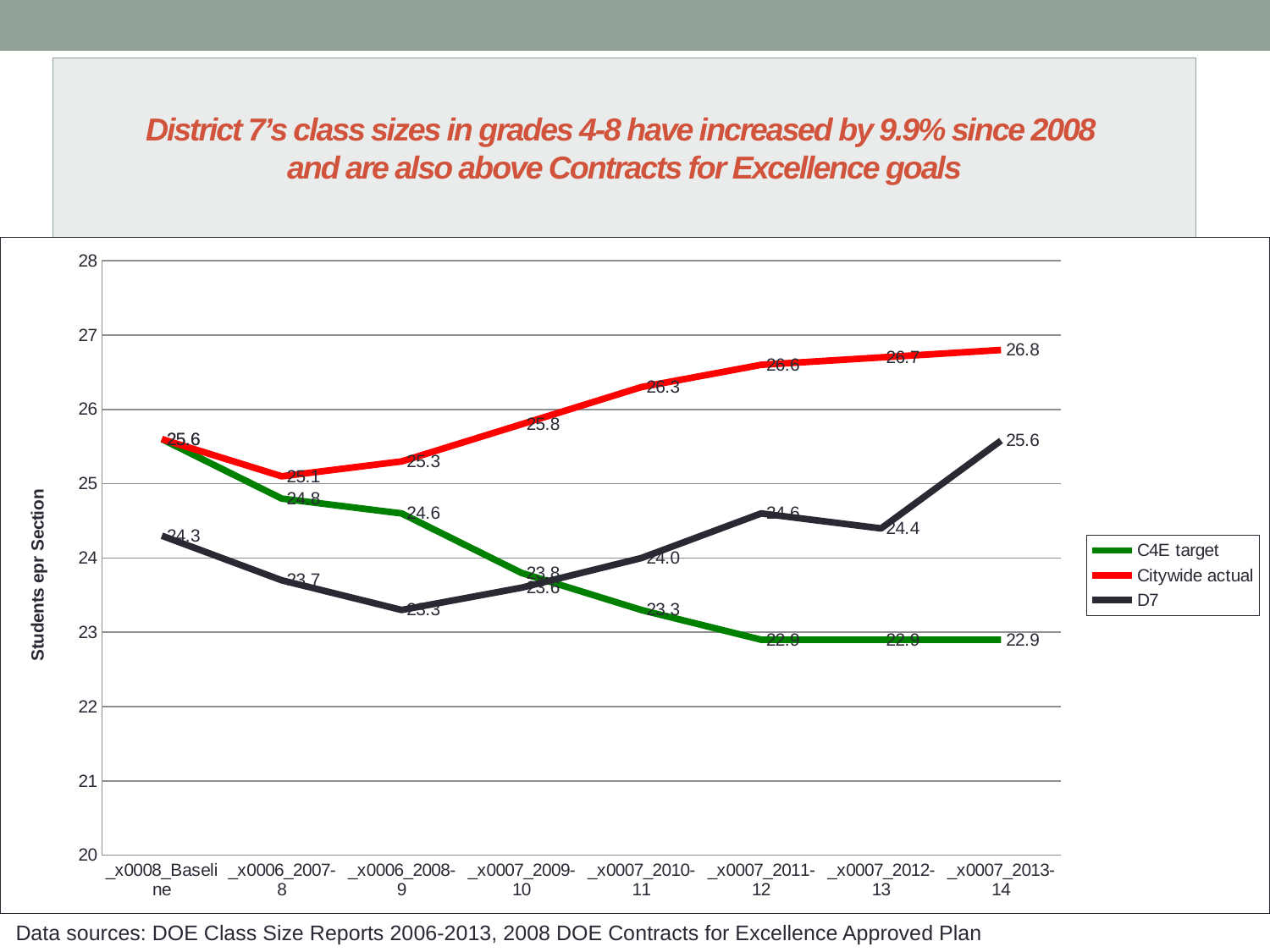
Which is larger in 2010-11, the D7 value or the C4E target value? D7 In which year is the Citywide actual value highest? 2013-14 What type of chart is shown on the slide? Line chart What is the Citywide actual value for 2009-10? 25.8 How many series does the legend list? 3 In which year is the D7 value lowest? 2008-9 What is the difference between the Citywide actual and D7 values in 2013-14? 1.2 How many points along the x axis does each line have? 8 What is the D7 value at the Baseline point? 24.3 Does the Citywide actual line generally rise or fall from 2007-8 to 2013-14? Rise What is the D7 value for 2013-14? 25.6 What is the Citywide actual value for 2013-14? 26.8